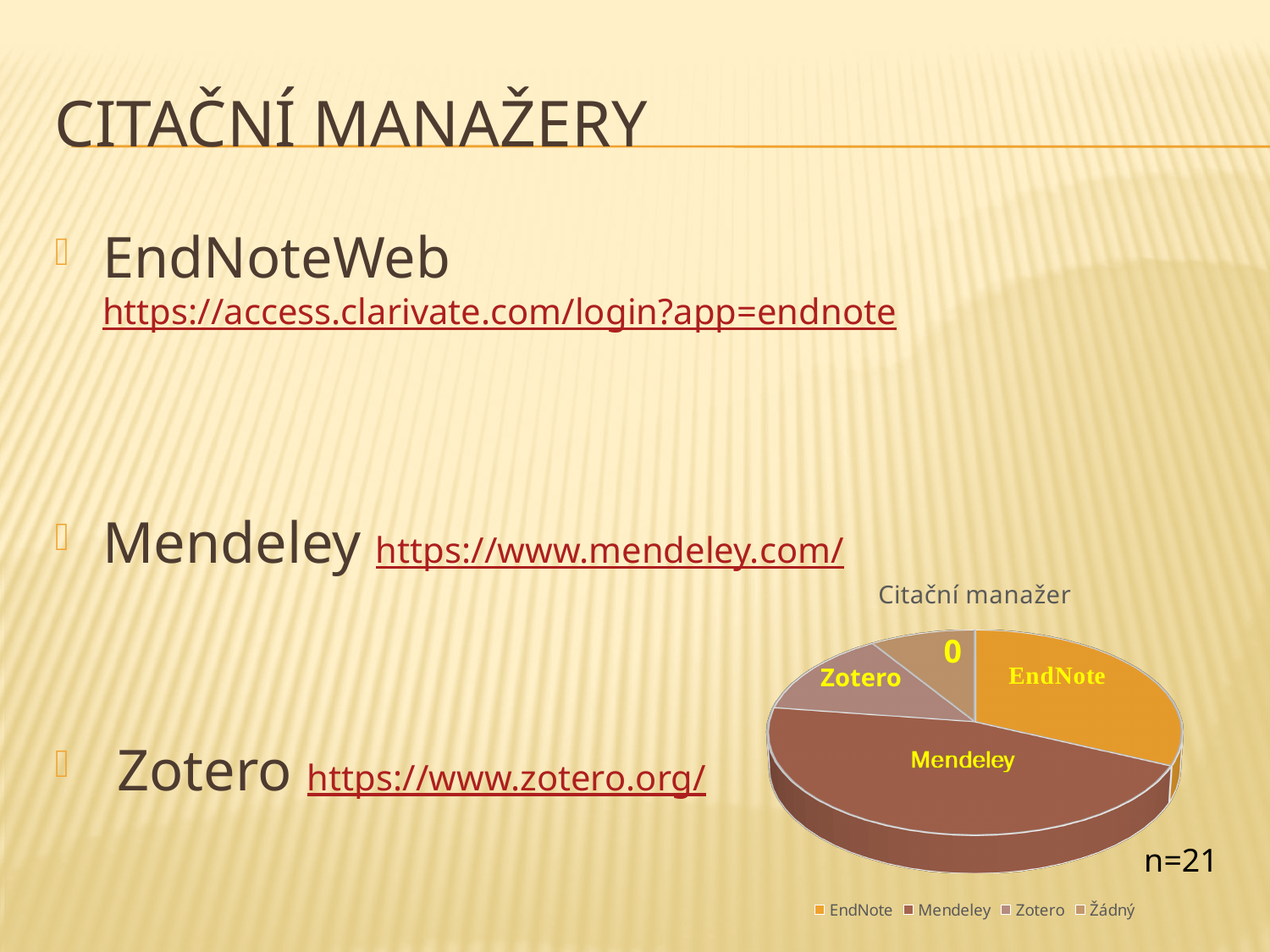
Which slice is larger in the pie chart, Mendeley or EndNote? Mendeley How many slices does the pie chart have? 4 What sample size is written next to the pie chart? n=21 What is the title of the pie chart? Citační manažer Which legend entry comes first in the pie chart's legend? EndNote Which slice is larger in the pie chart, EndNote or Zotero? EndNote Which category has the largest slice in the pie chart? Mendeley How many entries does the legend of the pie chart list? 4 What kind of chart is shown on the slide? pie chart Which category has the smallest slice in the pie chart? Žádný Which slice is larger in the pie chart, Zotero or Žádný? Zotero